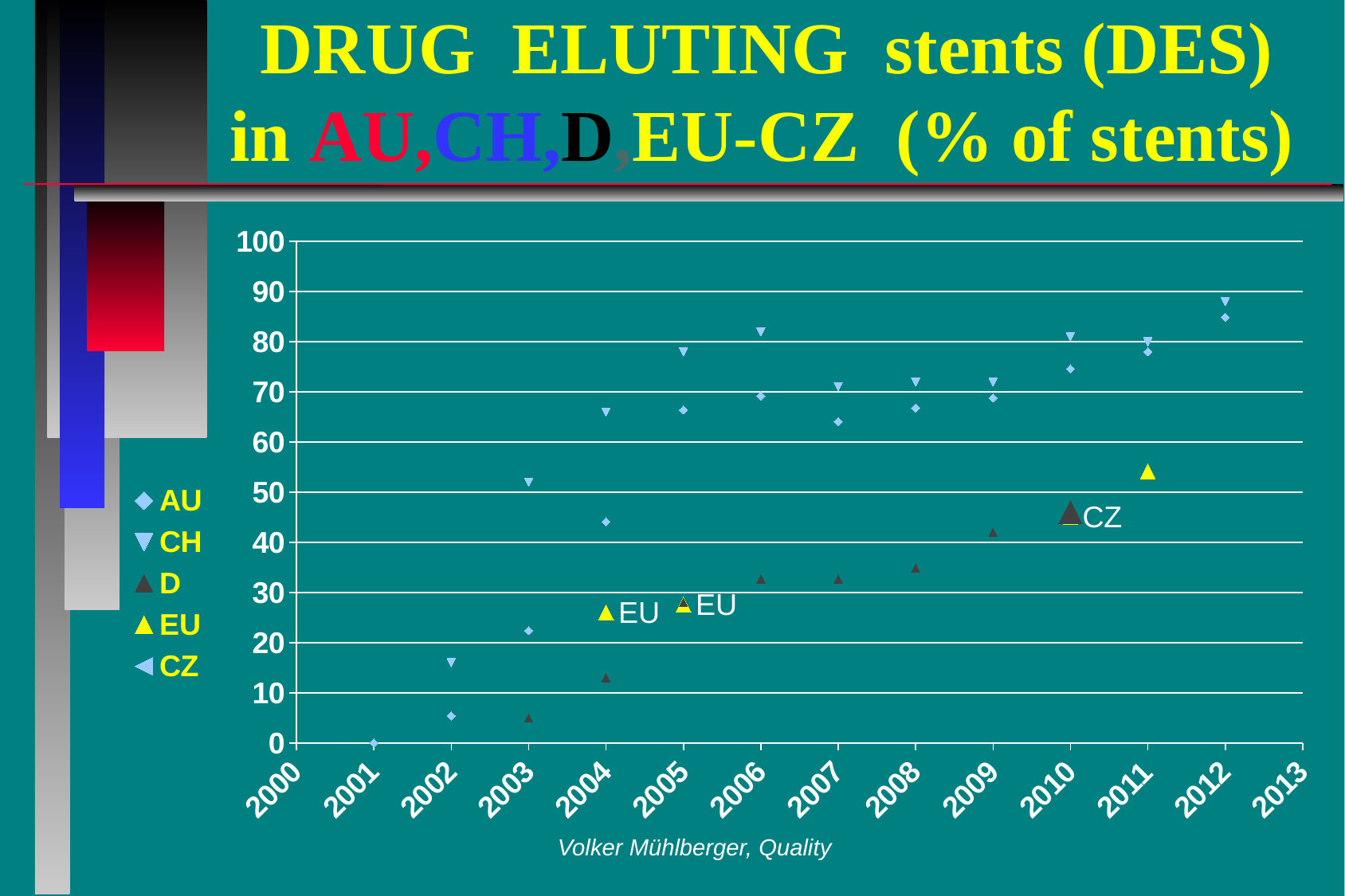
Do the values for D rise or fall from 2003 to 2010? rise How many year labels are shown on the x axis? 14 Which is larger in 2008, the value for CH or the value for D? CH Is the value for EU in 2011 greater or less than 50? greater Is the value for CH in 2006 greater or less than 80? greater Which is larger in 2004, the value for CH or the value for AU? CH Is the value for CH in 2012 greater or less than 80? greater How many series does the legend list? 5 What kind of chart is shown on the slide? scatter chart Which series are listed in the legend? AU, CH, D, EU, CZ